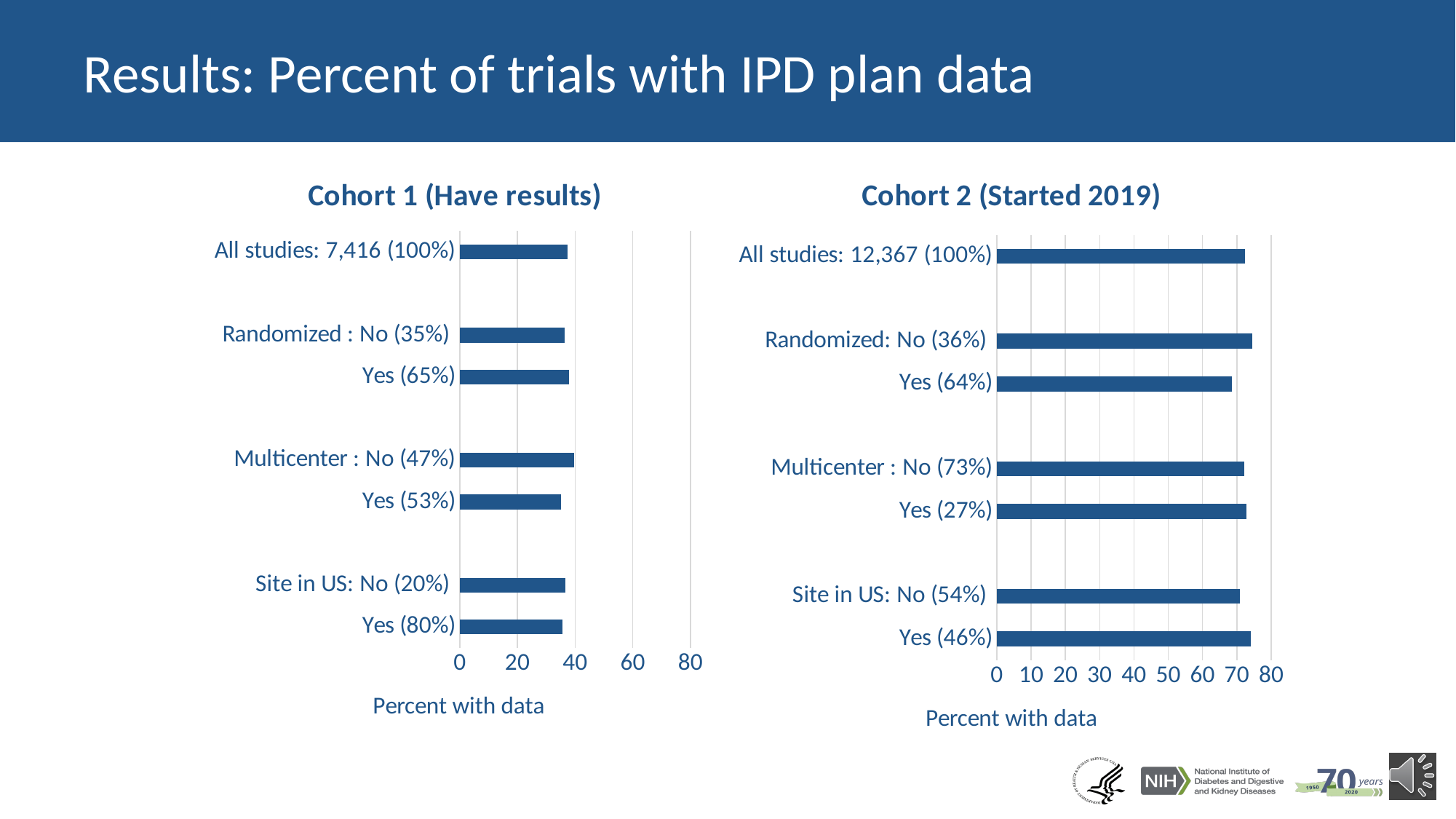
In the Cohort 2 (Started 2019) chart, which category has the lowest percent with data? Randomized: Yes In the Cohort 1 (Have results) chart, is the value for All studies greater or less than 40? less In the Cohort 2 (Started 2019) chart, which is larger: Randomized: No or Randomized: Yes? Randomized: No In the Cohort 1 (Have results) chart, is the value for Site in US: Yes greater or less than 20? greater What kind of chart is the Cohort 1 (Have results) chart? bar chart How many categories are plotted in the Cohort 2 (Started 2019) chart? 7 In the Cohort 2 (Started 2019) chart, is the value for All studies greater or less than 70? greater In the Cohort 1 (Have results) chart, which is larger: Multicenter: No or Multicenter: Yes? Multicenter: No What is the title of the chart on the right side of the slide? Cohort 2 (Started 2019) What is the x-axis title of the Cohort 1 (Have results) chart? Percent with data